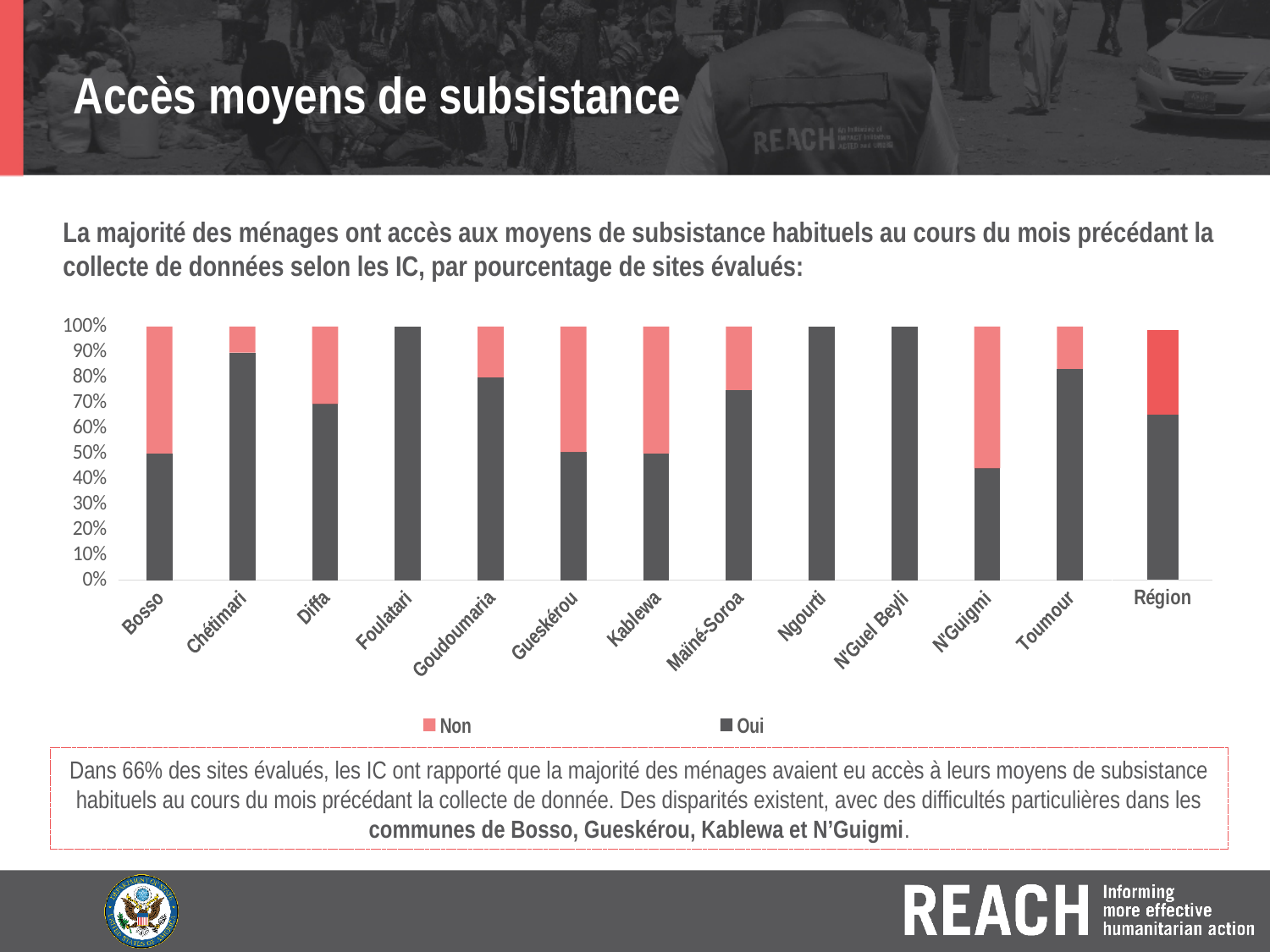
Which has the larger 'Non' value, N'Guigmi or Toumour? N'Guigmi Which category has the lowest 'Oui' value? N'Guigmi What are the two series named in the chart's legend? Non and Oui What is the 'Oui' value for Goudoumaria? 80% How many categories are shown along the x axis of the chart? 13 How many series does the chart's legend list? 2 Which has the larger 'Oui' value, Chétimari or Diffa? Chétimari What kind of chart is shown on the slide? Stacked bar chart Is the 'Oui' value for N'Guigmi greater or less than 50%? less What is the 'Oui' value for Foulatari? 100% Is the 'Oui' value for Chétimari greater or less than 80%? greater Is the 'Oui' value for Diffa greater or less than 60%? greater